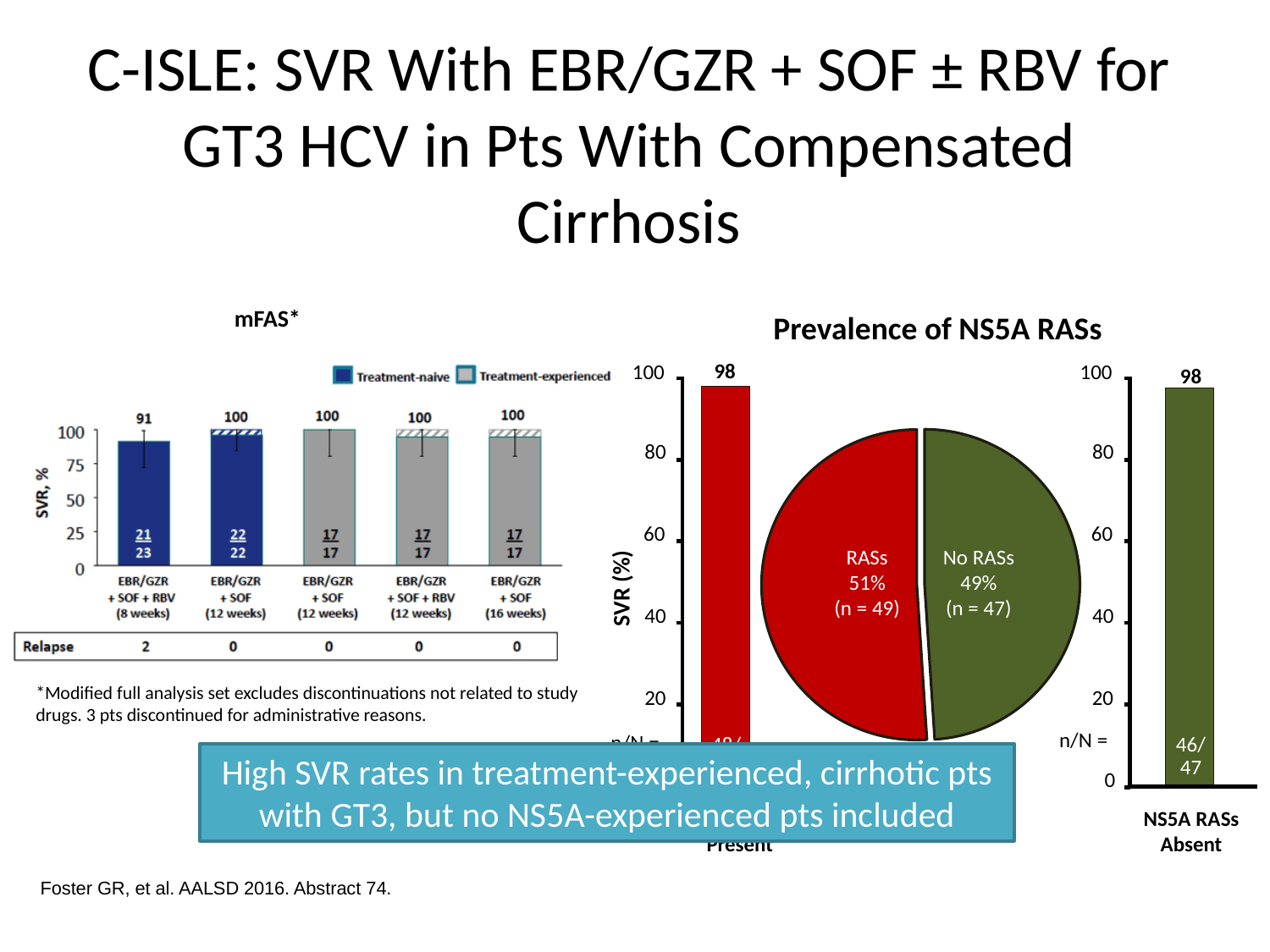
In the Prevalence of NS5A RASs pie chart, what is the n for the No RASs slice? n = 47 In the mFAS chart, which treatment arm has the lowest SVR? EBR/GZR + SOF + RBV (8 weeks) In the bar chart on the right for NS5A RASs Absent, what is the n/N shown on the bar? 46/47 In the Prevalence of NS5A RASs pie chart, which slice is larger, RASs or No RASs? RASs In the mFAS chart, how many treatment arms (bars) are shown? 5 In the mFAS chart, what kind of chart is used? Bar chart In the Prevalence of NS5A RASs pie chart, what share of patients had RASs? 51% In the bar chart on the right for NS5A RASs Absent, what is the SVR (%)? 98 In the mFAS chart, how many relapses are reported for the EBR/GZR + SOF + RBV (8 weeks) arm? 2 In the mFAS chart, what is the difference in SVR between EBR/GZR + SOF (12 weeks) and EBR/GZR + SOF + RBV (8 weeks)? 9 In the mFAS chart, how many series does the legend list? 2 In the mFAS chart, what is the SVR (%) for EBR/GZR + SOF + RBV (8 weeks)? 91